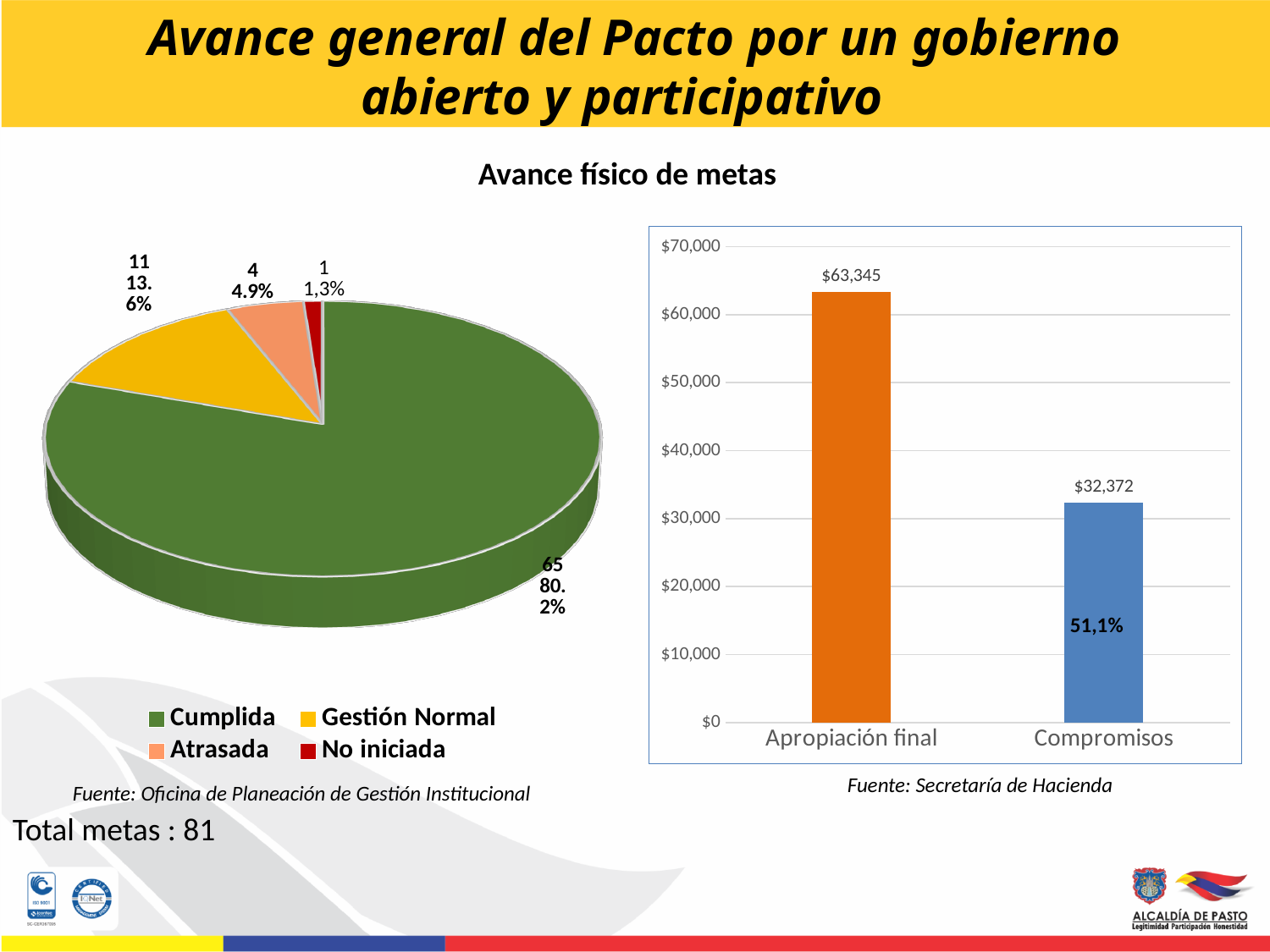
In the pie chart on the left, what percentage share does No iniciada have? 1,3% In the pie chart on the left, what percentage share does Gestión Normal have? 13.6% In the bar chart on the right, what is the difference between Apropiación final and Compromisos? $30,973 In the bar chart on the right, what is the value for Compromisos? $32,372 In the bar chart on the right, which category has the higher value, Apropiación final or Compromisos? Apropiación final In the pie chart on the left, which category has the smallest slice? No iniciada What type of chart is shown on the right side of the slide? Bar chart In the pie chart on the left, which category has the largest slice? Cumplida In the pie chart on the left, how many categories does the legend list? 4 In the pie chart on the left, what is the difference in count between Cumplida and Gestión Normal? 54 In the pie chart on the left, how many metas are in the Cumplida category? 65 In the bar chart on the right, what is the value for Apropiación final? $63,345